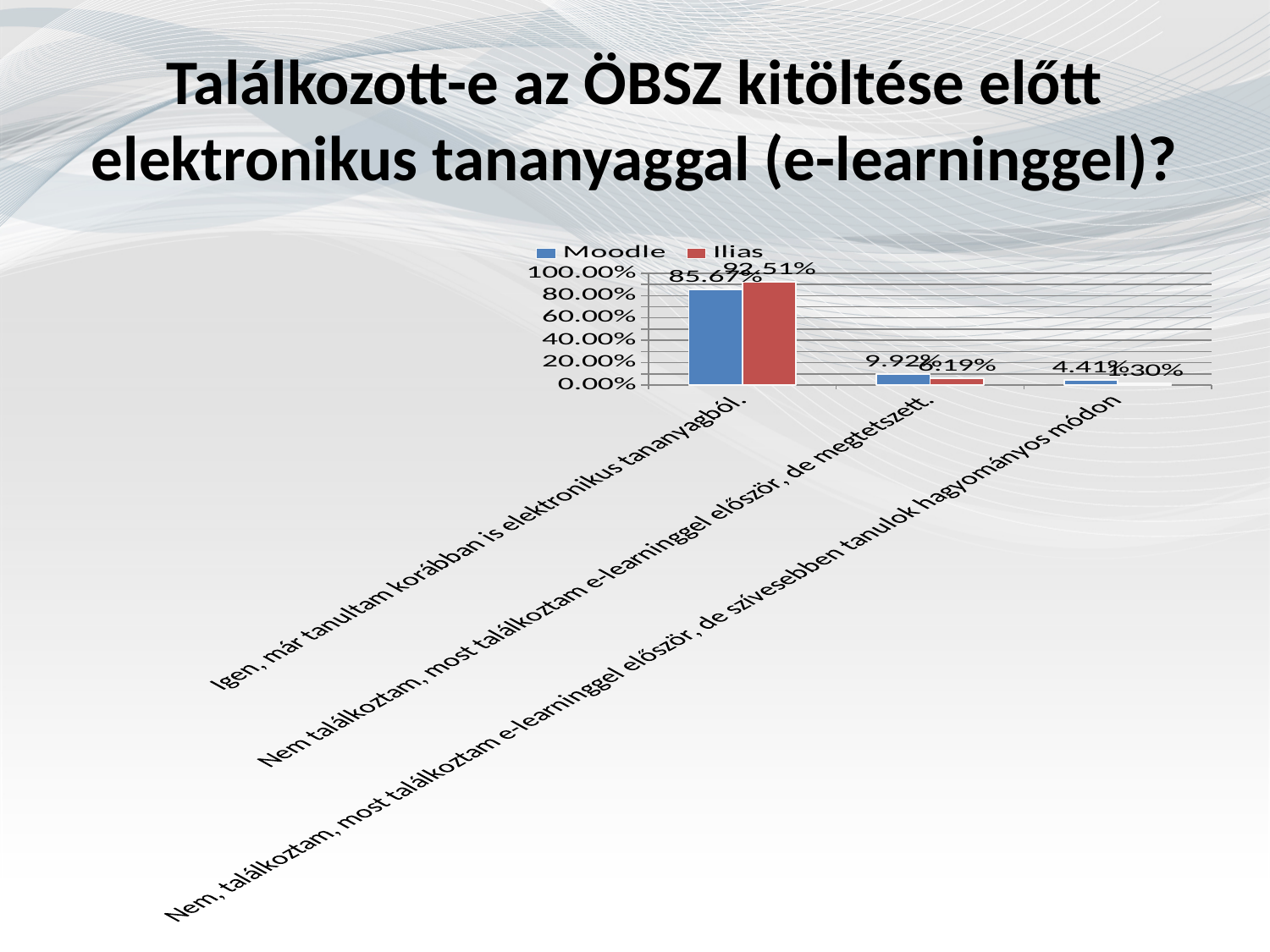
Which category has the highest Ilias value? Igen, már tanultam korábban is elektronikus tananyagból. What is the Moodle value for "Nem találkoztam, most találkoztam e-learninggel először, de megtetszett."? 9.92% Which two series are listed in the legend? Moodle and Ilias For "Igen, már tanultam korábban is elektronikus tananyagból.", which series has the larger value, Moodle or Ilias? Ilias How many series does the legend list? 2 What is the Ilias value for "Nem találkoztam, most találkoztam e-learninggel először, de megtetszett."? 6.19% How many categories are shown on the x axis? 3 What is the difference between the Ilias and Moodle values for "Igen, már tanultam korábban is elektronikus tananyagból."? 6.84% What is the Moodle value for "Nem, találkoztam, most találkoztam e-learninggel először, de szívesebben tanulok hagyományos módon"? 4.41% What is the Ilias value for "Igen, már tanultam korábban is elektronikus tananyagból."? 92.51% What kind of chart is shown on the slide? bar chart What is the Moodle value for "Igen, már tanultam korábban is elektronikus tananyagból."? 85.67%